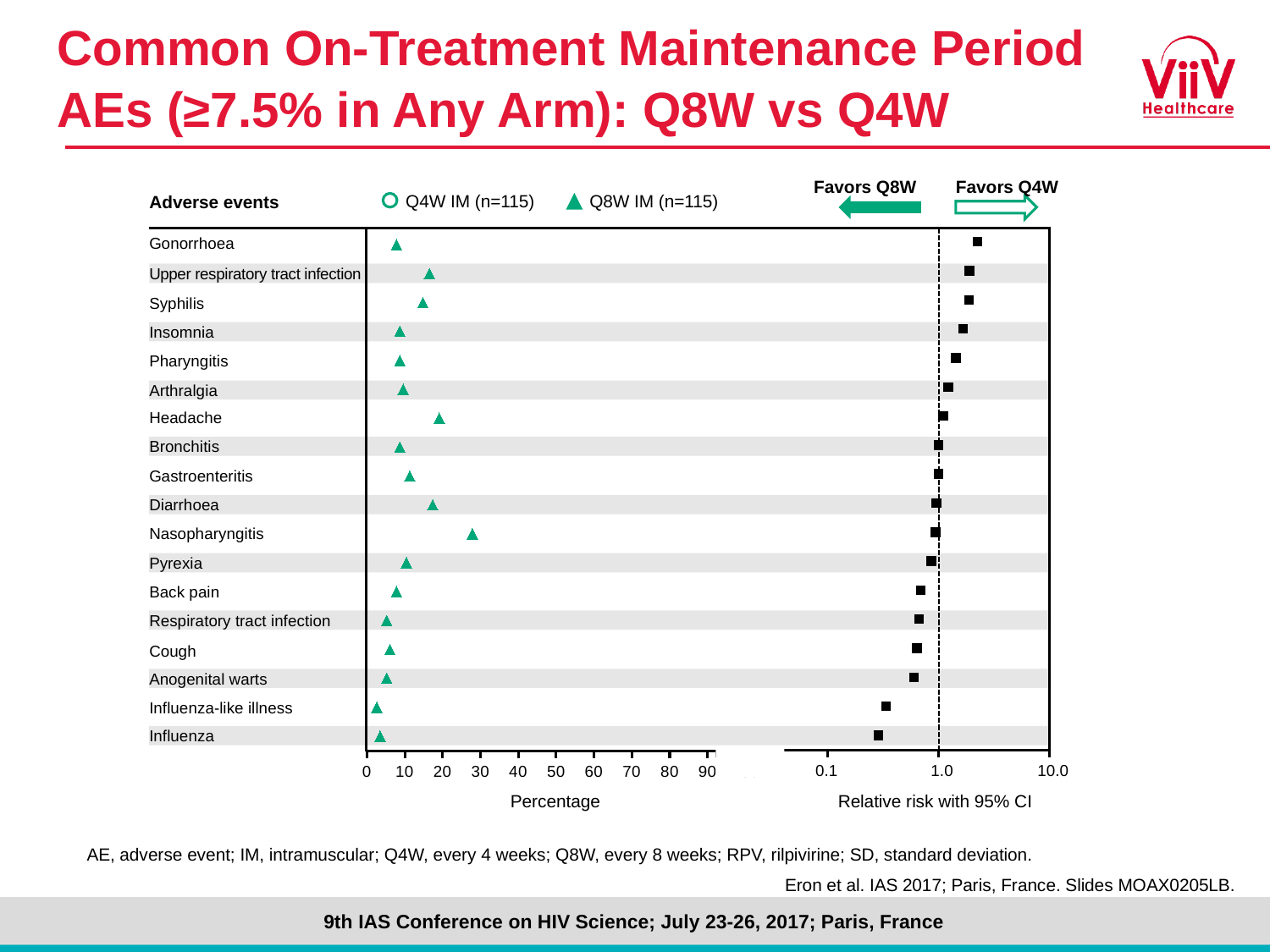
On the left chart (Percentage), how many series does the legend list? 2 On the left chart (Percentage), is the Q8W IM value for Nasopharyngitis greater or less than 20? greater On the left chart (Percentage), which adverse event has the highest Q8W IM percentage? Nasopharyngitis On the left chart (Percentage), how many adverse event categories are listed? 18 On the left chart (Percentage), is the Q8W IM value for Syphilis greater or less than 10? greater On the left chart (Percentage), is the Q8W IM value for Cough greater or less than 10? less What is the x-axis label of the right chart? Relative risk with 95% CI On the right chart (Relative risk with 95% CI), which has the larger relative risk, Gonorrhoea or Influenza? Gonorrhoea What are the two legend entries on the left chart? Q4W IM (n=115) and Q8W IM (n=115) On the left chart (Percentage), which has the larger Q8W IM percentage, Nasopharyngitis or Cough? Nasopharyngitis